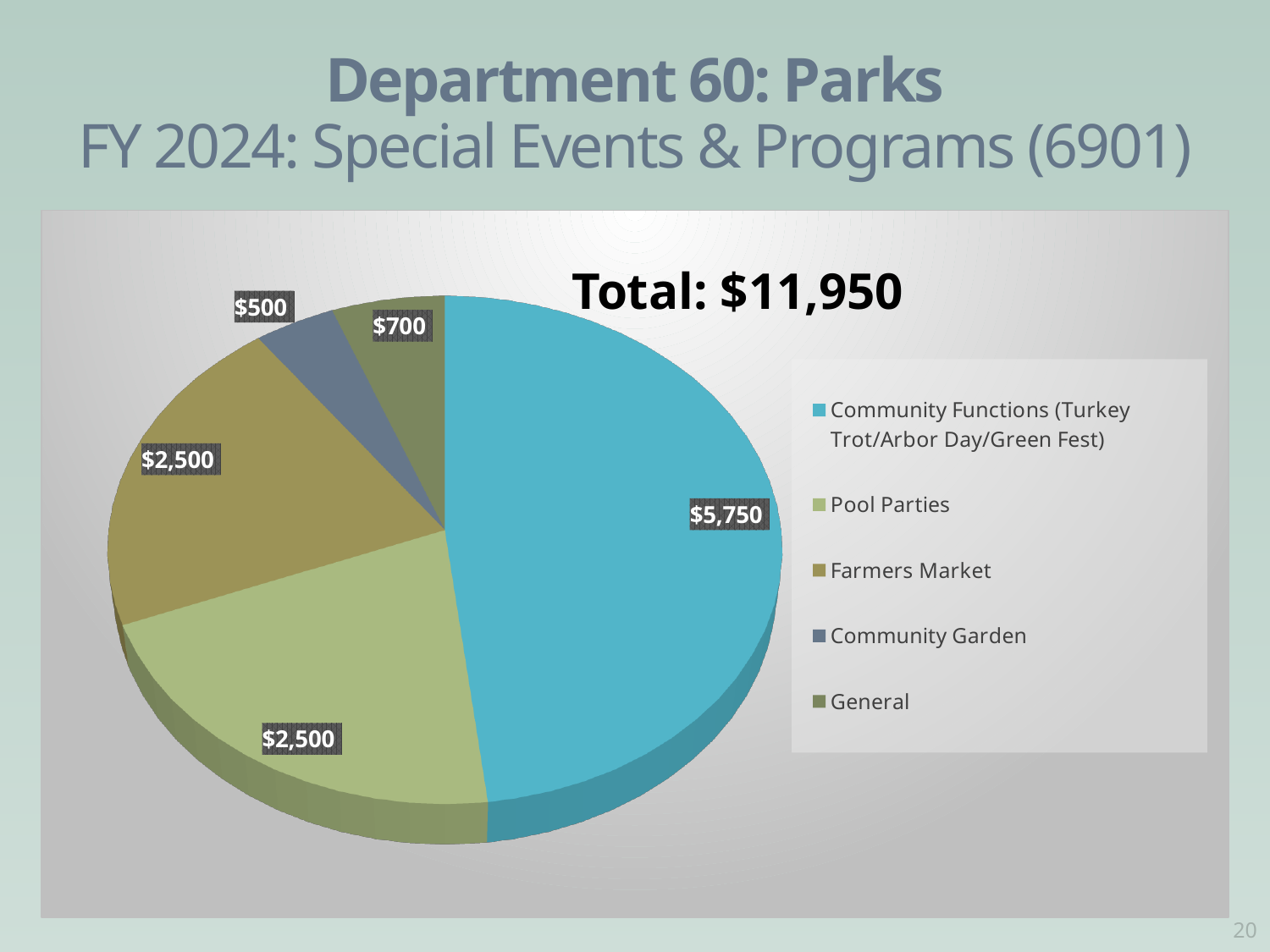
Which is larger, the value for General or the value for Community Garden? General What is the value for Community Functions (Turkey Trot/Arbor Day/Green Fest)? $5,750 What is the value for Community Garden? $500 What is the value for Pool Parties? $2,500 What is the difference between the Community Functions value and the General value? $5,050 How many categories are shown in the pie chart? 5 What is the title of the slide? Department 60: Parks FY 2024: Special Events & Programs (6901) What kind of chart is shown on the slide? Pie chart What total amount is shown on the chart? $11,950 Which category has the largest slice of the pie? Community Functions (Turkey Trot/Arbor Day/Green Fest) What is the value for General? $700 Which category has the smallest slice of the pie? Community Garden